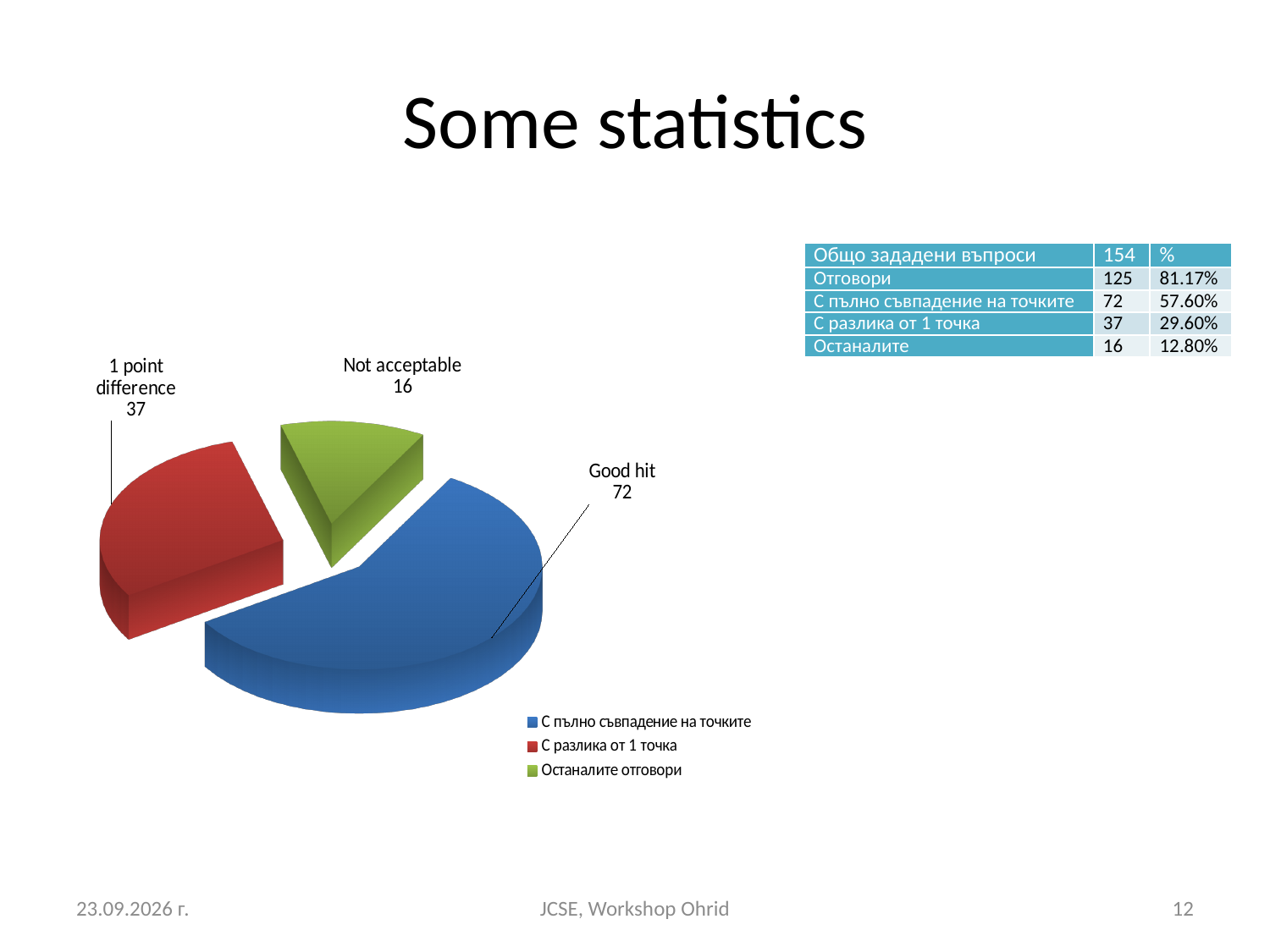
What colour is the Good hit slice in the pie chart? blue What share of the pie does the Good hit slice represent? 57.60% What is the difference between the 1 point difference value and the Not acceptable value in the pie chart? 21 How many slices does the pie chart have? 3 Which is larger in the pie chart, 1 point difference or Not acceptable? 1 point difference What is the value of the Good hit slice in the pie chart? 72 What is the difference between the Good hit value and the 1 point difference value in the pie chart? 35 Which slice of the pie chart is the largest? Good hit What is the value of the Not acceptable slice in the pie chart? 16 What is the value of the 1 point difference slice in the pie chart? 37 Which slice of the pie chart is the smallest? Not acceptable What type of chart is shown on the slide? pie chart